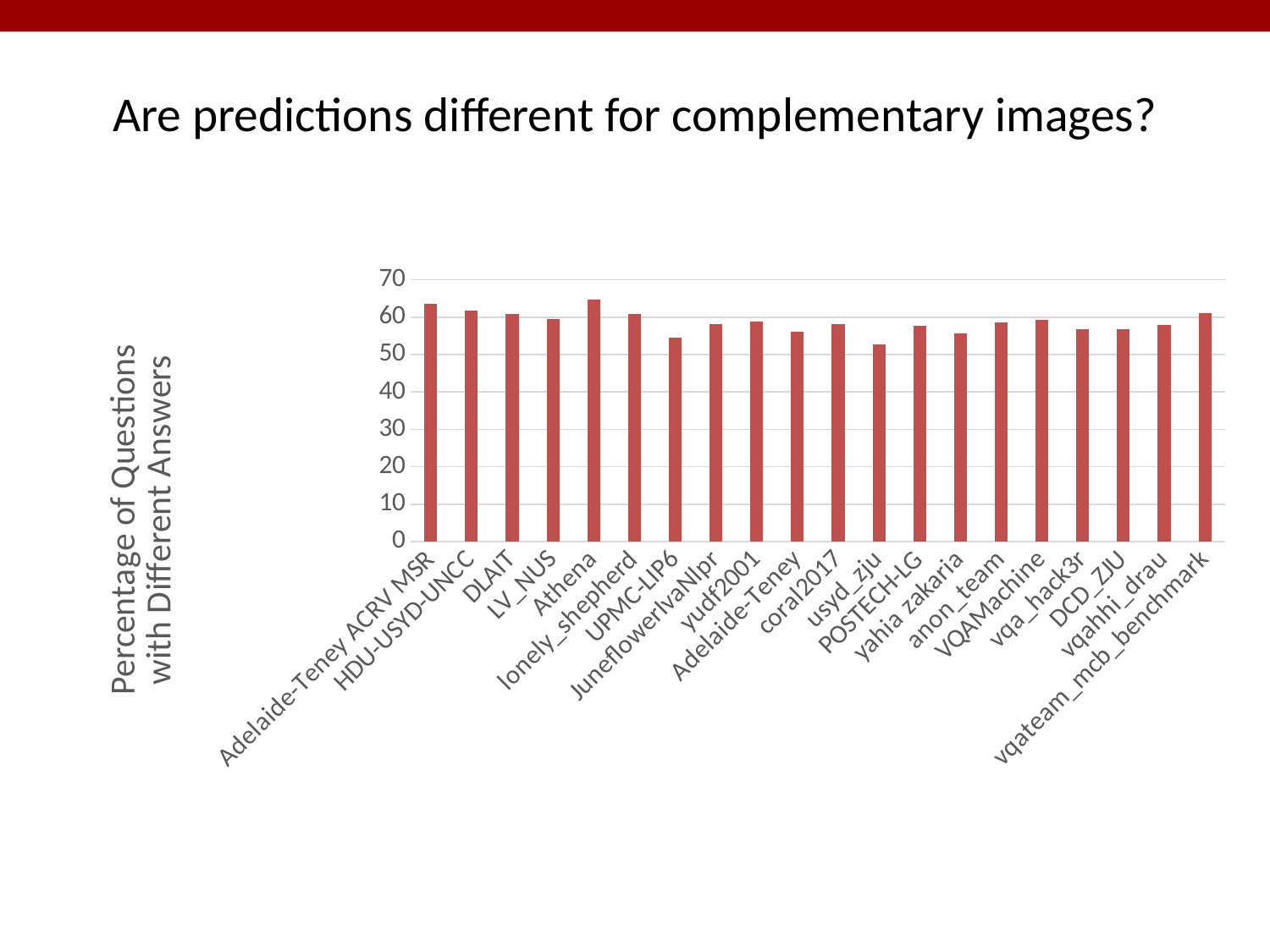
Is the value for usyd_zju greater or less than 60? less Is the value for usyd_zju greater or less than 50? greater Is the value for Athena greater or less than 60? greater How many teams (bars) are shown in the chart? 20 What is the label of the vertical axis of the chart? Percentage of Questions with Different Answers Which team has the highest percentage of questions with different answers? Athena What is the title of the slide containing the chart? Are predictions different for complementary images? Which is larger, the value for Adelaide-Teney ACRV MSR or the value for UPMC-LIP6? Adelaide-Teney ACRV MSR What kind of chart is shown on the slide? bar chart Which team has the lowest percentage of questions with different answers? usyd_zju Which is larger, the value for Athena or the value for usyd_zju? Athena